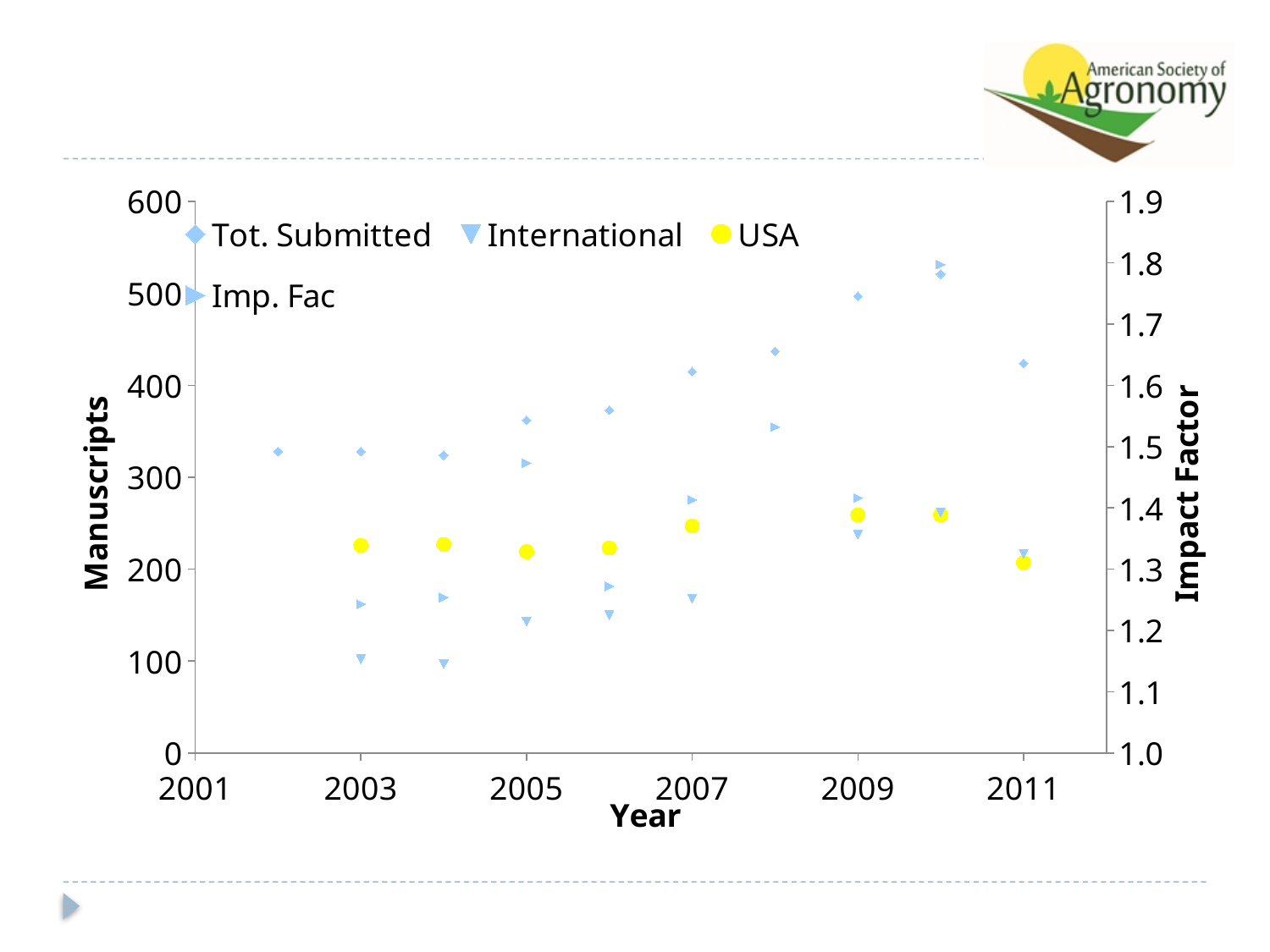
In which year is the USA value lowest? 2011 Which is larger, the Tot. Submitted value for 2010 or for 2011? 2010 In which year is the Imp. Fac value highest? 2010 How many series does the legend list? 4 What kind of chart is shown on the slide? scatter chart In which year is the Tot. Submitted value highest? 2010 Is the International value for 2003 greater or less than 200? less What is the title of the left vertical axis? Manuscripts Is the Imp. Fac value for 2010 greater or less than 1.7? greater What is the title of the right vertical axis? Impact Factor Is the Tot. Submitted value for 2009 greater or less than 400? greater Does the Tot. Submitted series generally rise or fall from 2002 to 2010? rise